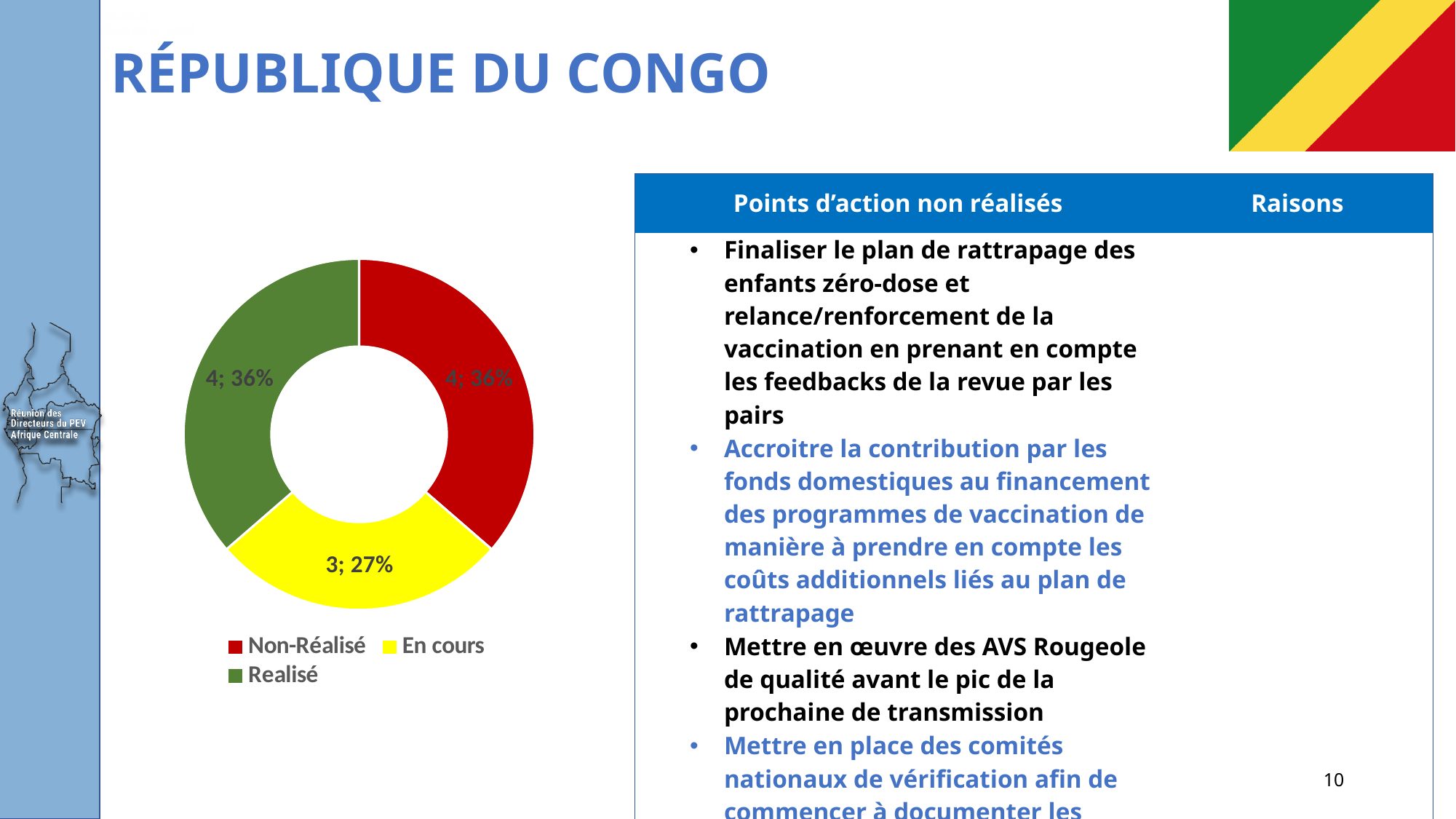
What is the difference between the count for 'Non-Réalisé' and the count for 'En cours'? 1 How many categories does the doughnut chart show? 3 How many entries does the legend of the doughnut chart list? 3 What share of the doughnut chart does 'Realisé' represent? 36% What kind of chart is shown on the slide? Doughnut (pie) chart What is the value shown for the 'Non-Réalisé' slice? 4; 36% Which is larger, the 'Non-Réalisé' slice or the 'En cours' slice? Non-Réalisé What is the value shown for the 'En cours' slice? 3; 27% What share of the doughnut chart does 'En cours' represent? 27% What colour represents 'Realisé' in the doughnut chart? Green What is the value shown for the 'Realisé' slice? 4; 36% Which category has the smallest slice in the doughnut chart? En cours